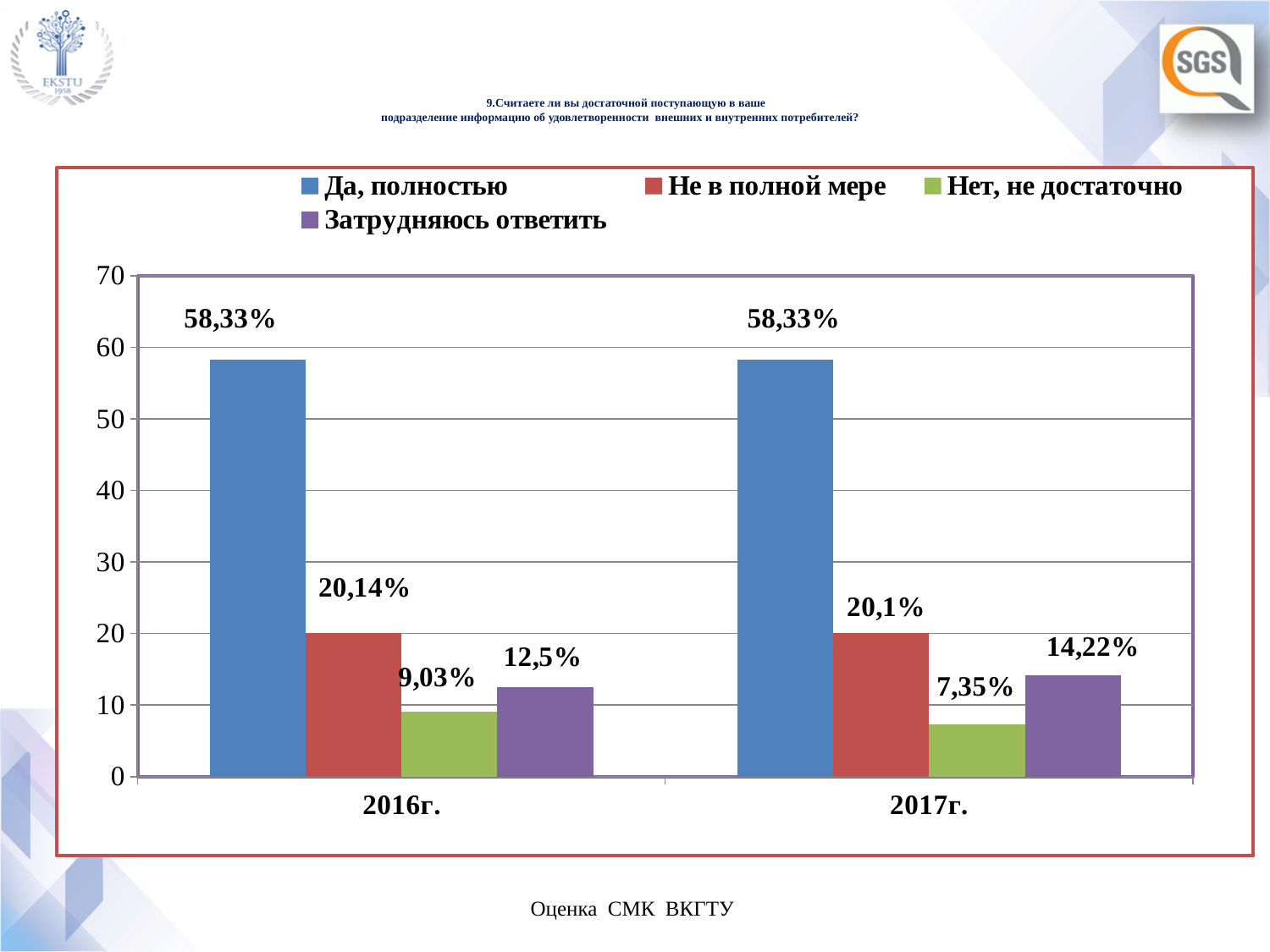
What is the value for "Нет, не достаточно" in 2016г.? 9,03% What is the value for "Не в полной мере" in 2017г.? 20,1% Which series has the highest value in 2017г.? Да, полностью How many series does the legend list? 4 What kind of chart is shown on the slide? bar chart Which is larger: "Нет, не достаточно" in 2016г. or in 2017г.? 2016г. Which series has the lowest value in 2016г.? Нет, не достаточно What is the difference between the "Затрудняюсь ответить" values for 2017г. and 2016г.? 1,72% Which colour represents the series "Не в полной мере"? red How many categories are shown on the x axis? 2 What is the value for "Да, полностью" in 2016г.? 58,33% What is the value for "Затрудняюсь ответить" in 2017г.? 14,22%